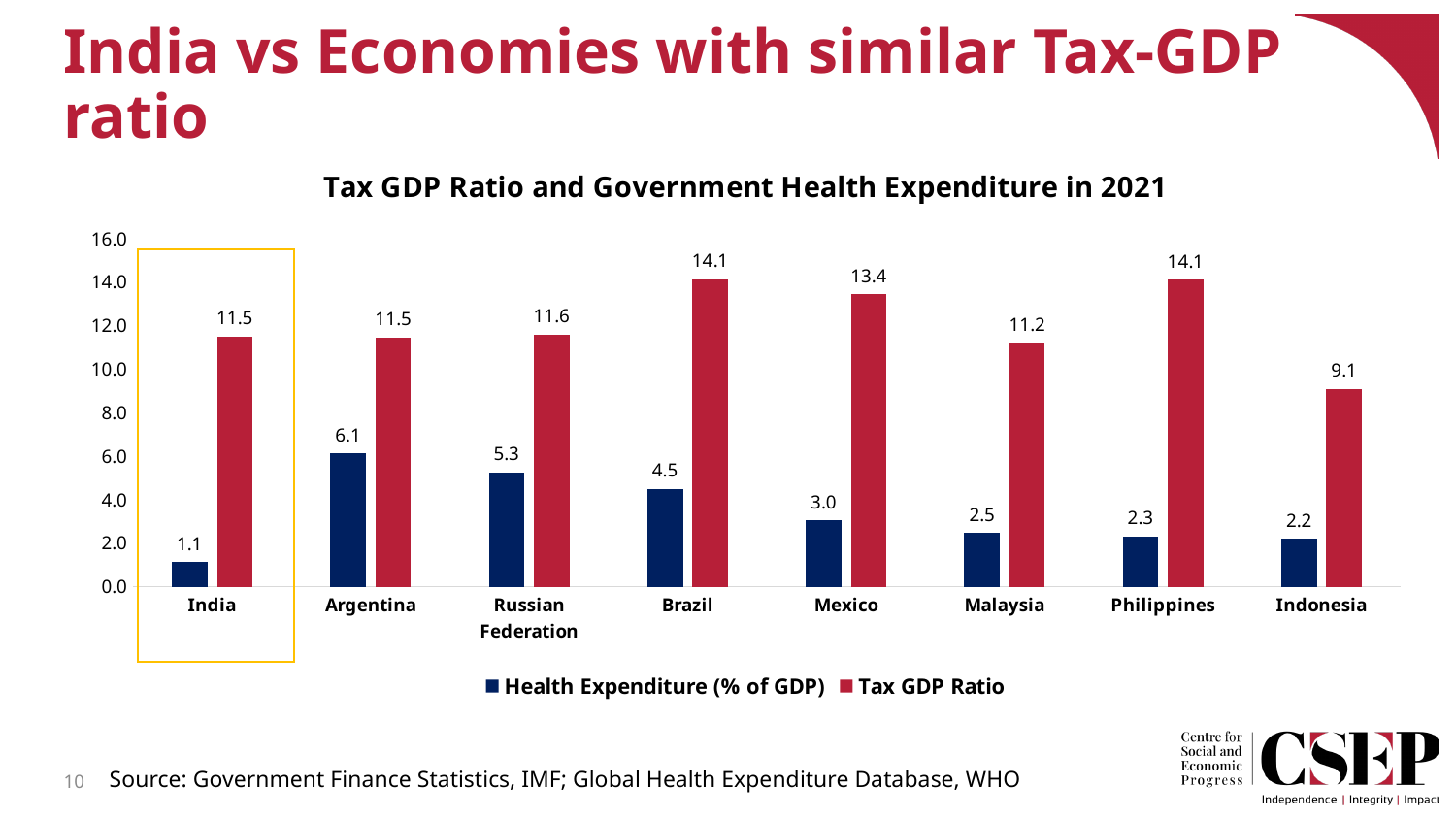
How many series does the legend list? 2 What is the Tax GDP Ratio for Indonesia? 9.1 Which country has the lowest Tax GDP Ratio? Indonesia How many countries are shown on the chart? 8 What kind of chart is shown on the slide? Bar chart Which is larger, the Health Expenditure (% of GDP) for Russian Federation or for Mexico? Russian Federation What is the title of the chart? Tax GDP Ratio and Government Health Expenditure in 2021 What is the difference between the Tax GDP Ratio and Health Expenditure (% of GDP) for Brazil? 9.6 Which country has the highest Health Expenditure (% of GDP)? Argentina What is the Tax GDP Ratio for Mexico? 13.4 What is the Health Expenditure (% of GDP) value for India? 1.1 Which country has the lowest Health Expenditure (% of GDP)? India